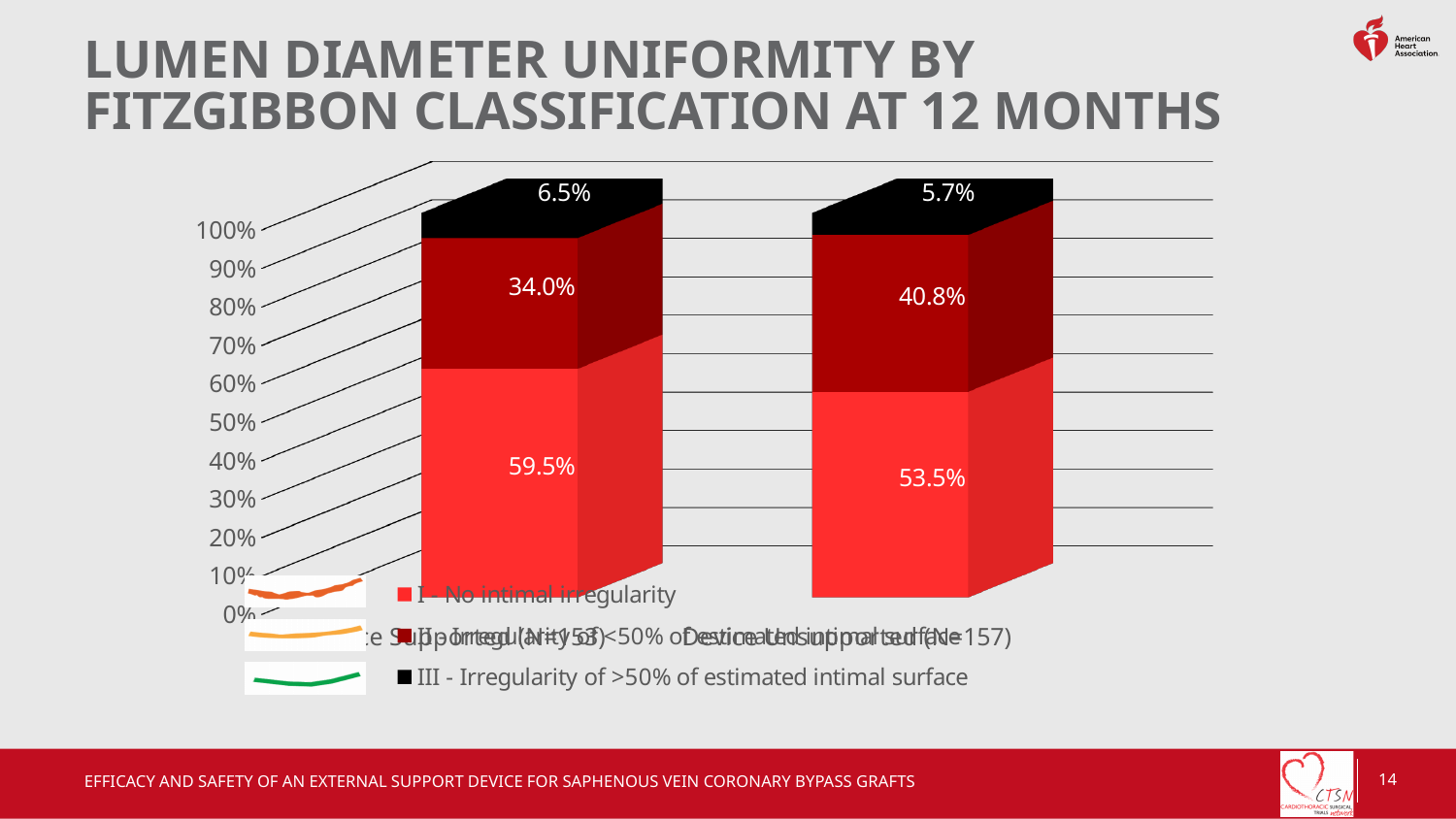
What is the value of the bottom (bright red) segment of the right bar? 53.5% What is the difference between the bottom segment values of the left bar (59.5%) and the right bar (53.5%)? 6.0 percentage points Which bar has the larger middle (dark red) segment, the left bar or the right bar? The right bar Which legend entry corresponds to the bottom (bright red) segments of the bars? I - No intimal irregularity Which bar has the larger top (black) segment, the left bar or the right bar? The left bar What is the value of the top (black) segment of the left bar? 6.5% What is the value of the bottom (bright red) segment of the left bar? 59.5% What is the value of the top (black) segment of the right bar? 5.7% How many stacked bars are plotted in the chart? 2 What is the value of the middle (dark red) segment of the right bar? 40.8% How many series does the legend list? 3 What kind of chart is shown on the slide? Stacked bar chart